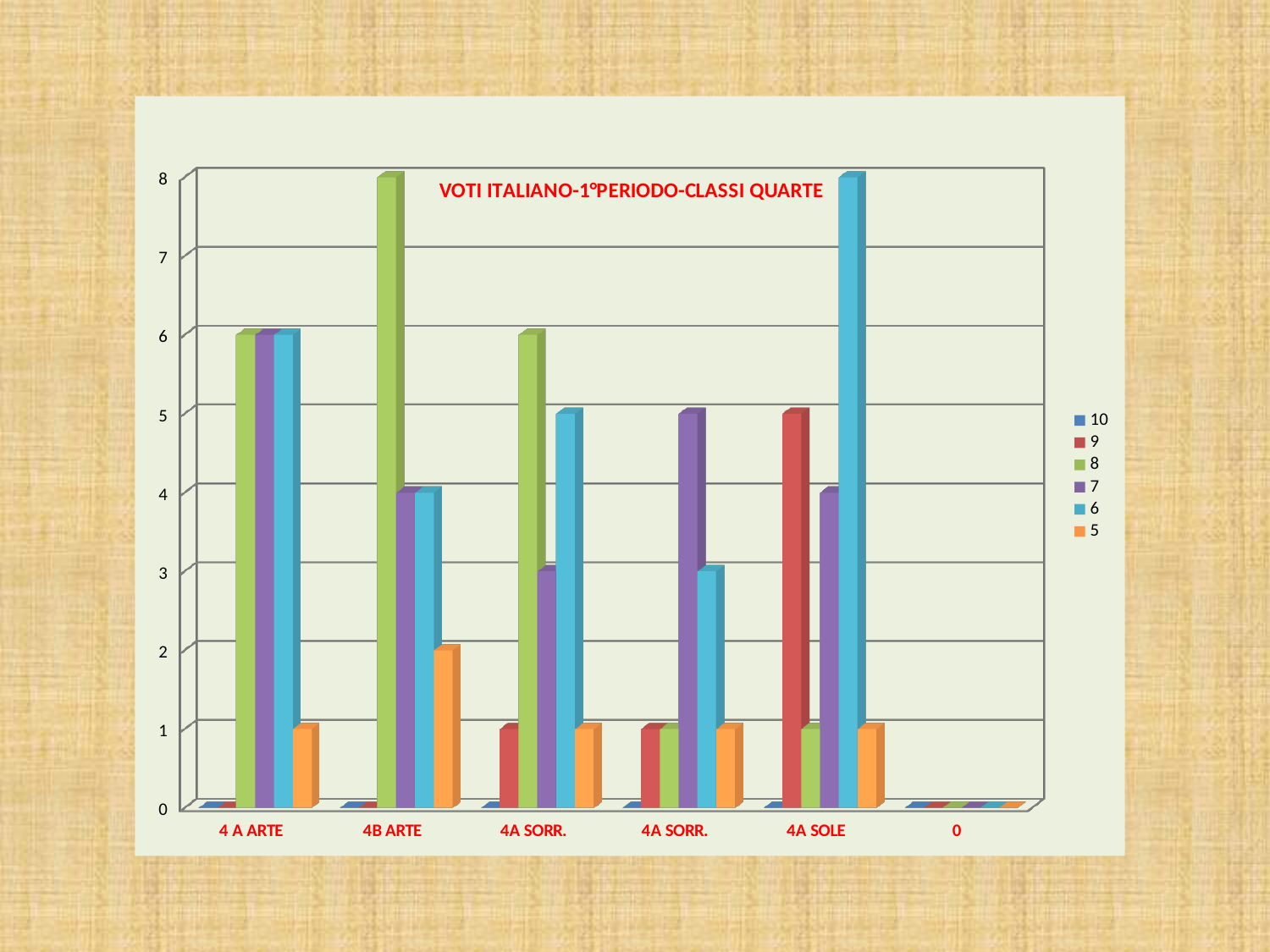
What kind of chart is shown on the slide? bar chart What is the value of series 8 for 4B ARTE? 8 How many series does the legend list? 6 What is the title of the chart? VOTI ITALIANO-1°PERIODO-CLASSI QUARTE What is the difference between series 8 for 4B ARTE and series 7 for 4B ARTE? 4 What is the value of series 6 for 4A SOLE? 8 How many categories are shown on the x axis? 6 Which is larger: series 8 for 4B ARTE or series 8 for 4 A ARTE? 4B ARTE Which category has the highest value for series 8? 4B ARTE What is the value of series 9 for 4A SOLE? 5 What is the value of series 5 for 4B ARTE? 2 Which category has the highest value for series 6? 4A SOLE